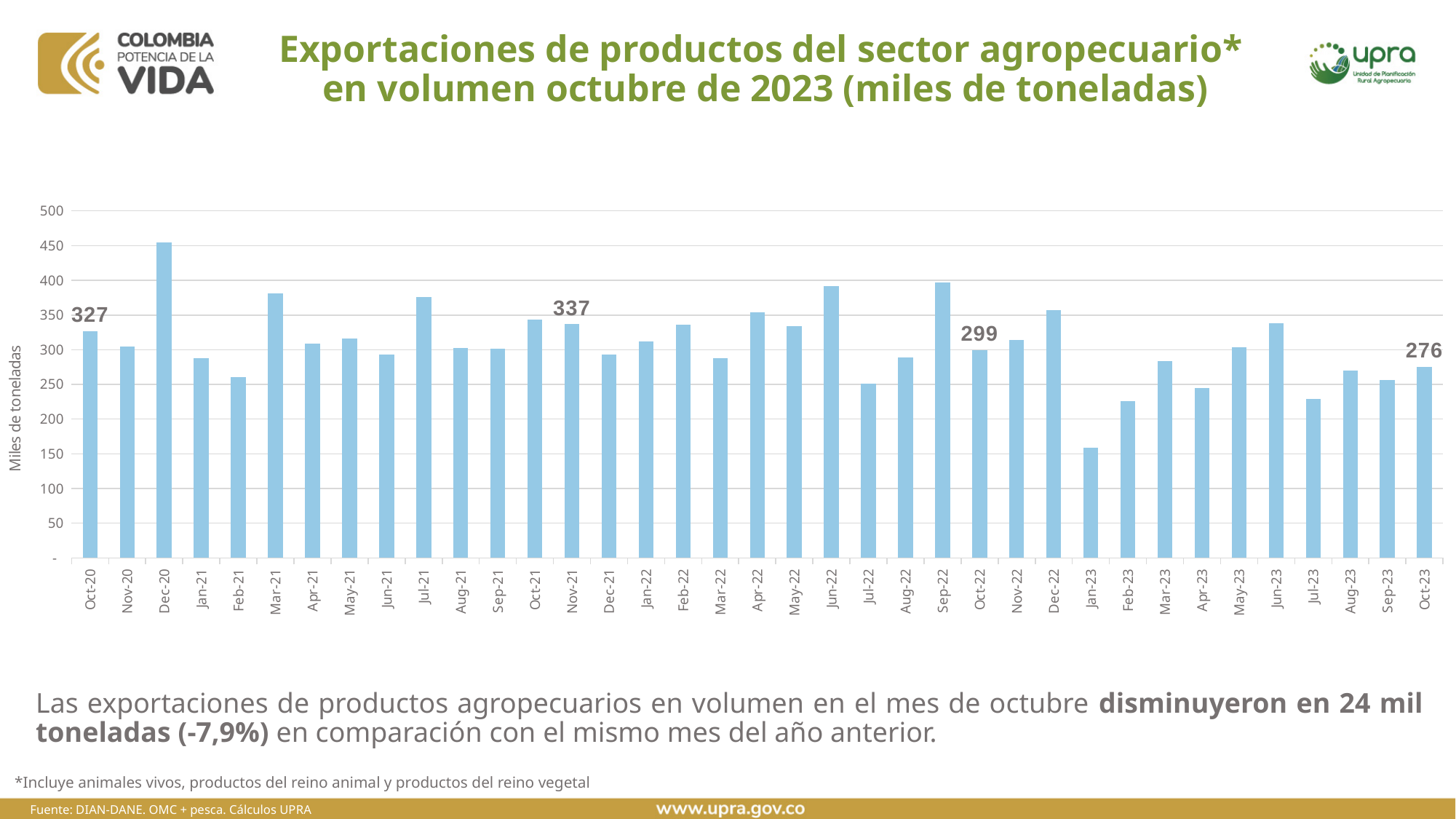
What is the value for Oct-23? 276 Which month has the highest value? Dec-20 How many months are plotted on the chart? 37 Which is larger, the value for Oct-20 or the value for Nov-21? Nov-21 What is the value for Oct-22? 299 Is the value for Dec-20 greater or less than 400? greater Which month has the lowest value? Jan-23 Is the value for Jan-23 greater or less than 200? less What is the value for Nov-21? 337 What kind of chart is shown on the slide? Bar chart What is the difference between the values for Oct-22 and Oct-23? 24 What is the value for Oct-20? 327